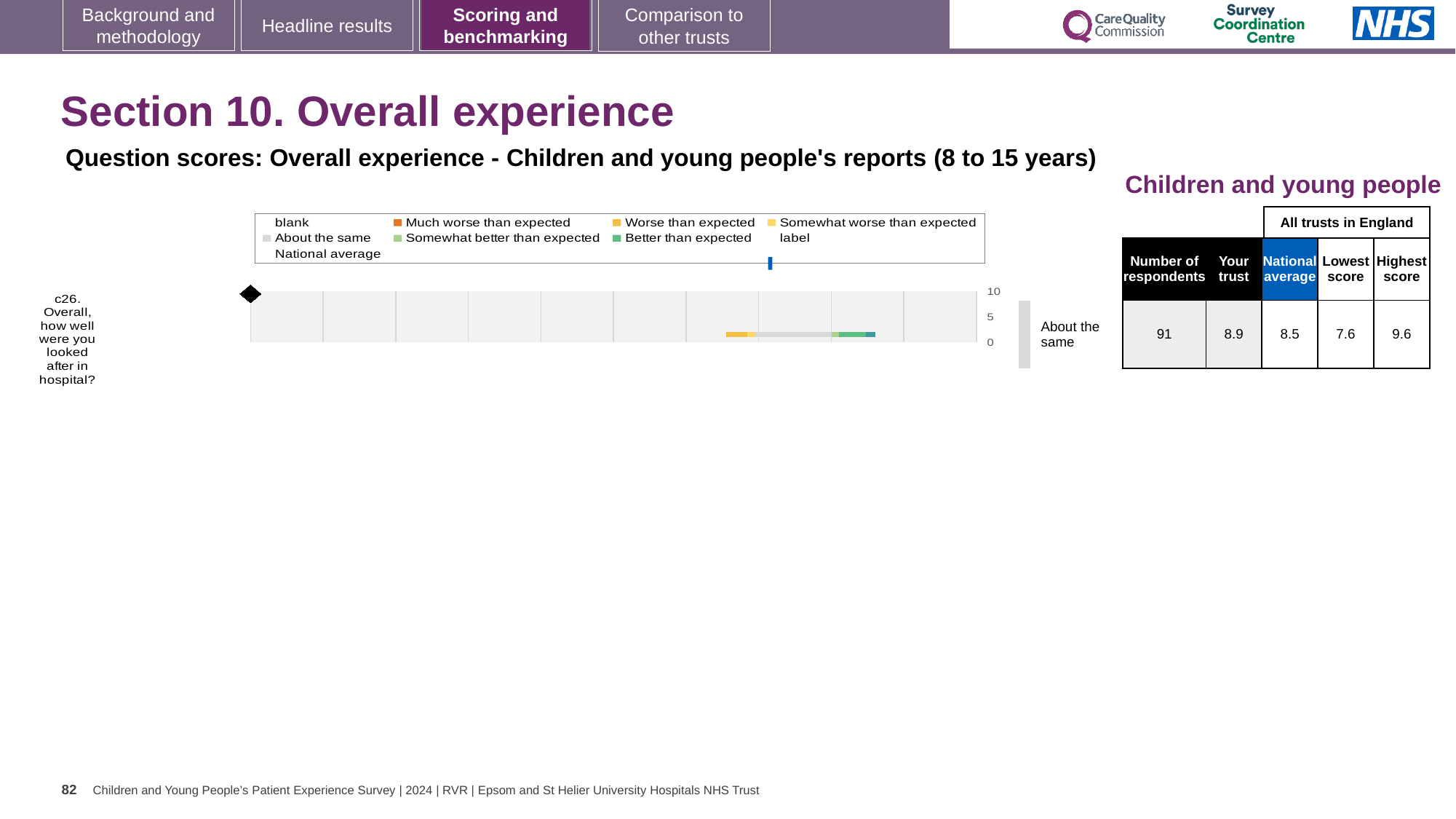
What is the national average score for question c26 shown on the slide? 8.5 How many questions (categories) are plotted on the chart? 1 What is the 'Your trust' score for question c26 shown on the slide? 8.9 Is the 'Your trust' score for question c26 higher or lower than the national average? higher What is the lowest score among all trusts in England for question c26? 7.6 How many respondents answered question c26? 91 What is the maximum value shown on the chart's score axis? 10 What benchmark category label is shown to the right of the chart for question c26? About the same What is the highest score among all trusts in England for question c26? 9.6 What is the difference between the highest score and the lowest score for question c26? 2.0 Which question is plotted on the chart? c26. Overall, how well were you looked after in hospital? What kind of chart is shown on the slide? bar chart